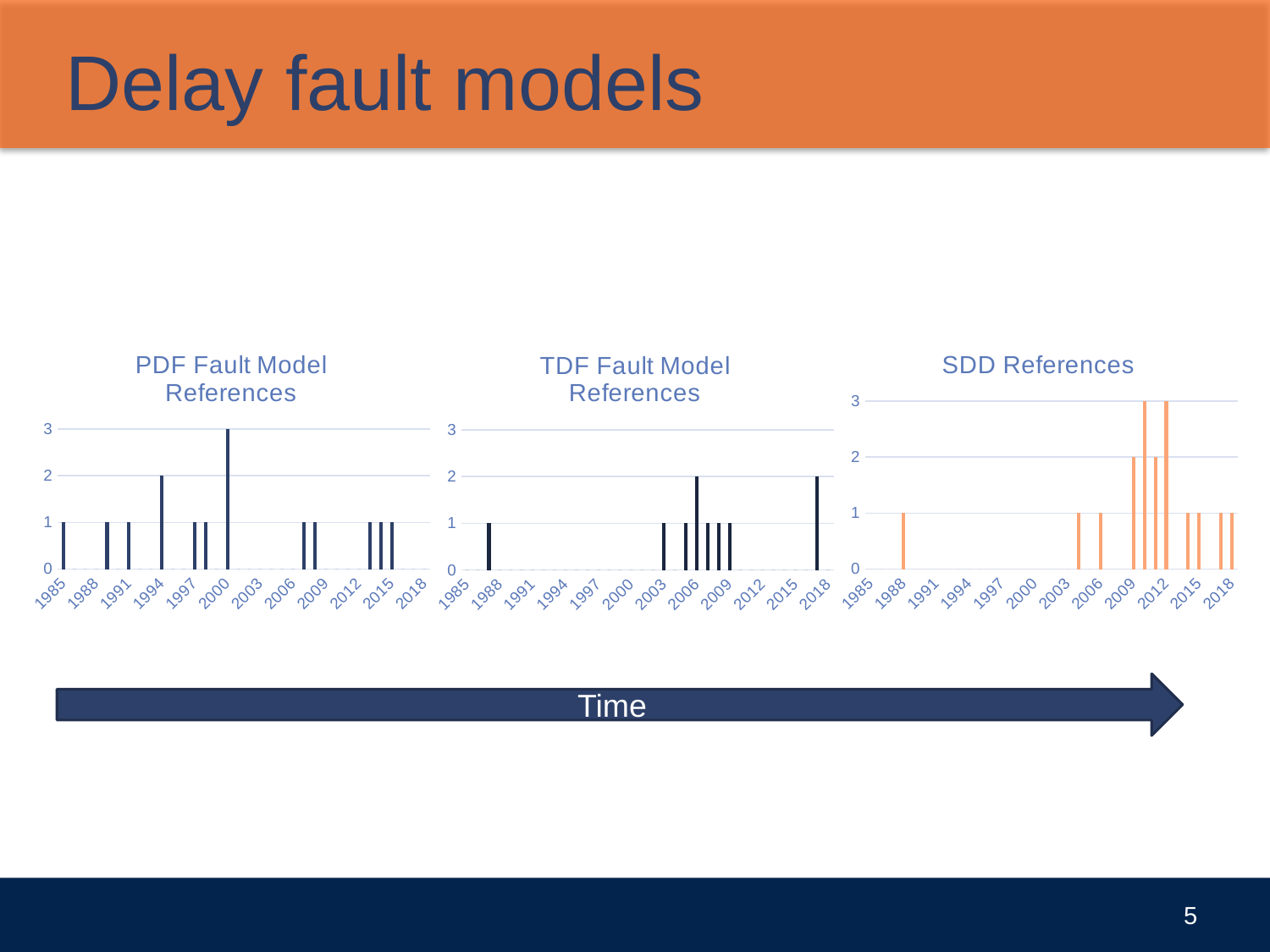
What kind of chart is the PDF Fault Model References chart? bar chart What is the title of the rightmost chart on the slide? SDD References In the PDF Fault Model References chart, what is the value for 2000? 3 In the SDD References chart, what is the highest value reached by any bar? 3 In the PDF Fault Model References chart, what is the highest value reached by any bar? 3 How many charts are shown on the slide? 3 In the PDF Fault Model References chart, what is the difference between the value for 2000 and the value for 1994? 1 In the PDF Fault Model References chart, what is the value for 1994? 2 In the PDF Fault Model References chart, what is the value for 1985? 1 In the PDF Fault Model References chart, which is larger, the value for 2000 or the value for 1994? 2000 In the PDF Fault Model References chart, which year has the tallest bar? 2000